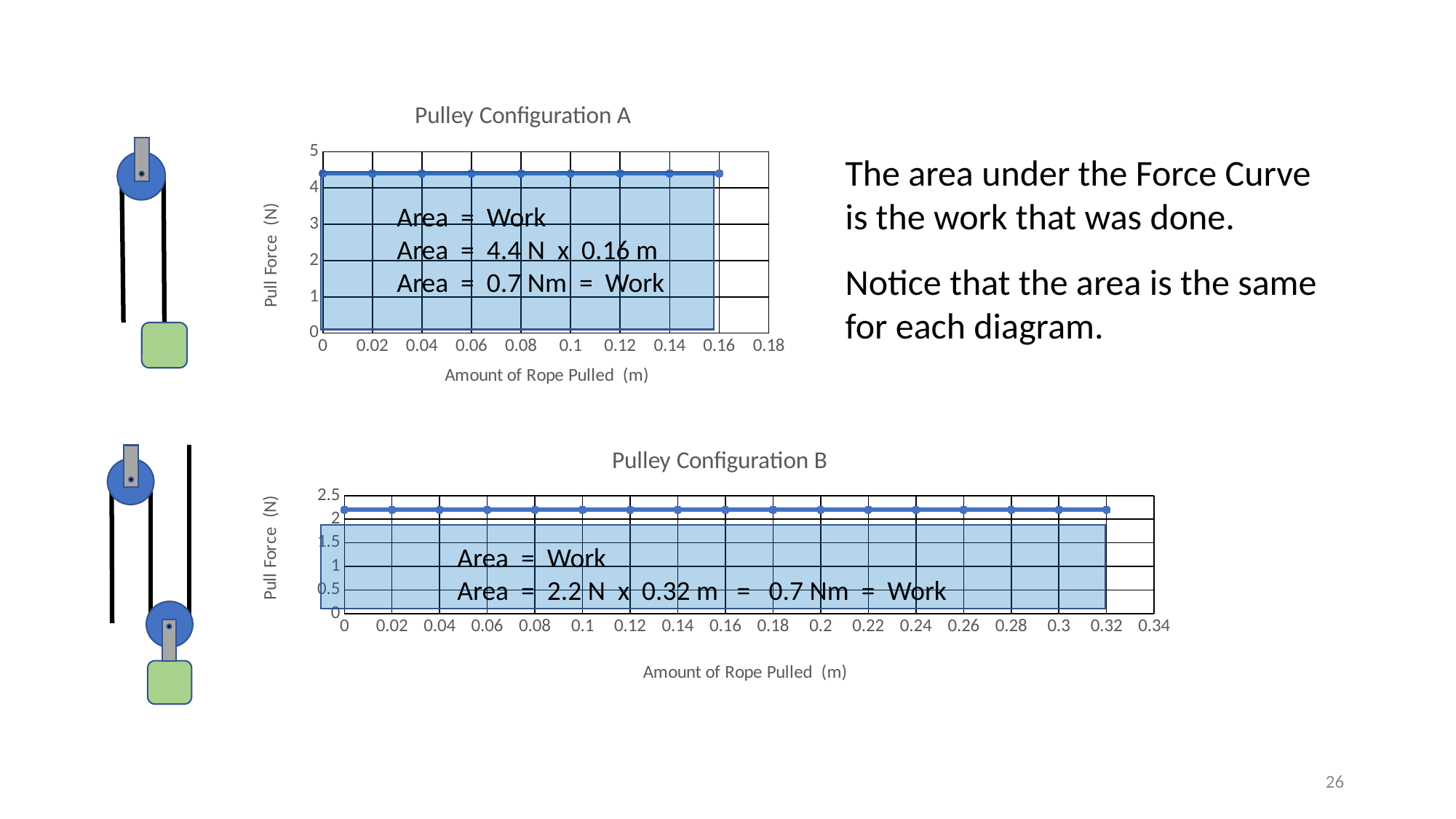
What kind of chart is the Pulley Configuration A chart? line chart How many data points are plotted in the Pulley Configuration A chart? 9 In the Pulley Configuration A chart, does the pull force rise, fall, or stay flat as the amount of rope pulled increases? stays flat In the Pulley Configuration B chart, is the pull force greater or less than 2 N? greater In the Pulley Configuration A chart, is the pull force greater or less than 4 N? greater In the Pulley Configuration B chart, does the pull force rise, fall, or stay flat as the amount of rope pulled increases? stays flat In the Pulley Configuration B chart, what is the largest amount of rope pulled at which a data point is plotted? 0.32 How many data points are plotted in the Pulley Configuration B chart? 17 According to the annotation on the Pulley Configuration A chart, what is the constant pull force? 4.4 N Which chart shows the larger pull force, Pulley Configuration A or Pulley Configuration B? Pulley Configuration A According to the annotation on the Pulley Configuration B chart, what is the constant pull force? 2.2 N What is the x-axis label of the Pulley Configuration A chart? Amount of Rope Pulled (m)